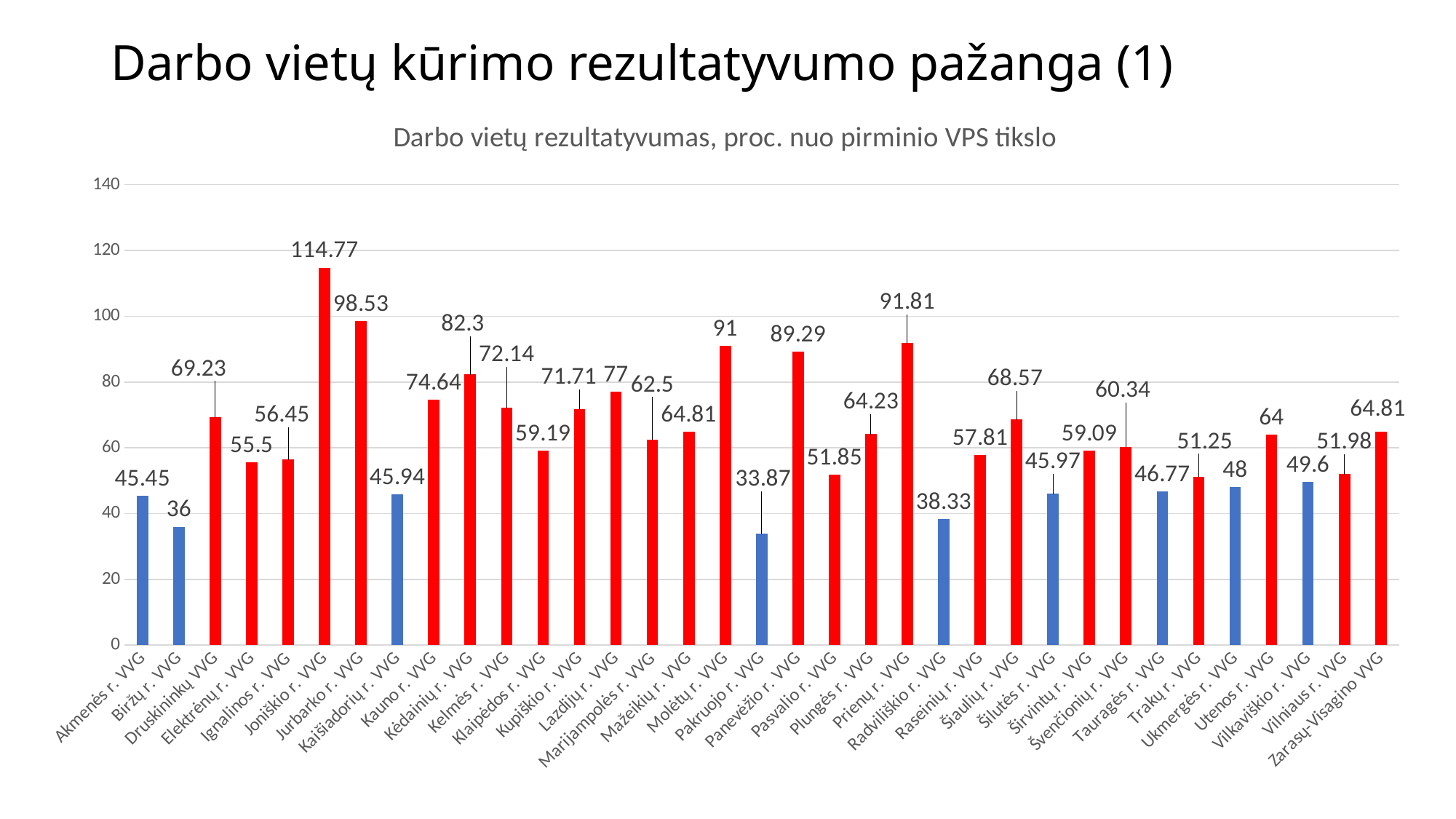
What is the value for Pakruojo r. VVG? 33.87 What is the difference between the values for Joniškio r. VVG and Jurbarko r. VVG? 16.24 Which category has the lowest value? Pakruojo r. VVG What is the title of the chart? Darbo vietų rezultatyvumas, proc. nuo pirminio VPS tikslo Which is larger, the value for Kėdainių r. VVG or the value for Kauno r. VVG? Kėdainių r. VVG What is the value for Joniškio r. VVG? 114.77 Is the value for Prienų r. VVG greater or less than 80? greater What colour is the bar for Biržų r. VVG? blue What is the value for Panevėžio r. VVG? 89.29 How many categories are shown on the x axis? 35 Which category has the highest value? Joniškio r. VVG What kind of chart is shown on the slide? bar chart